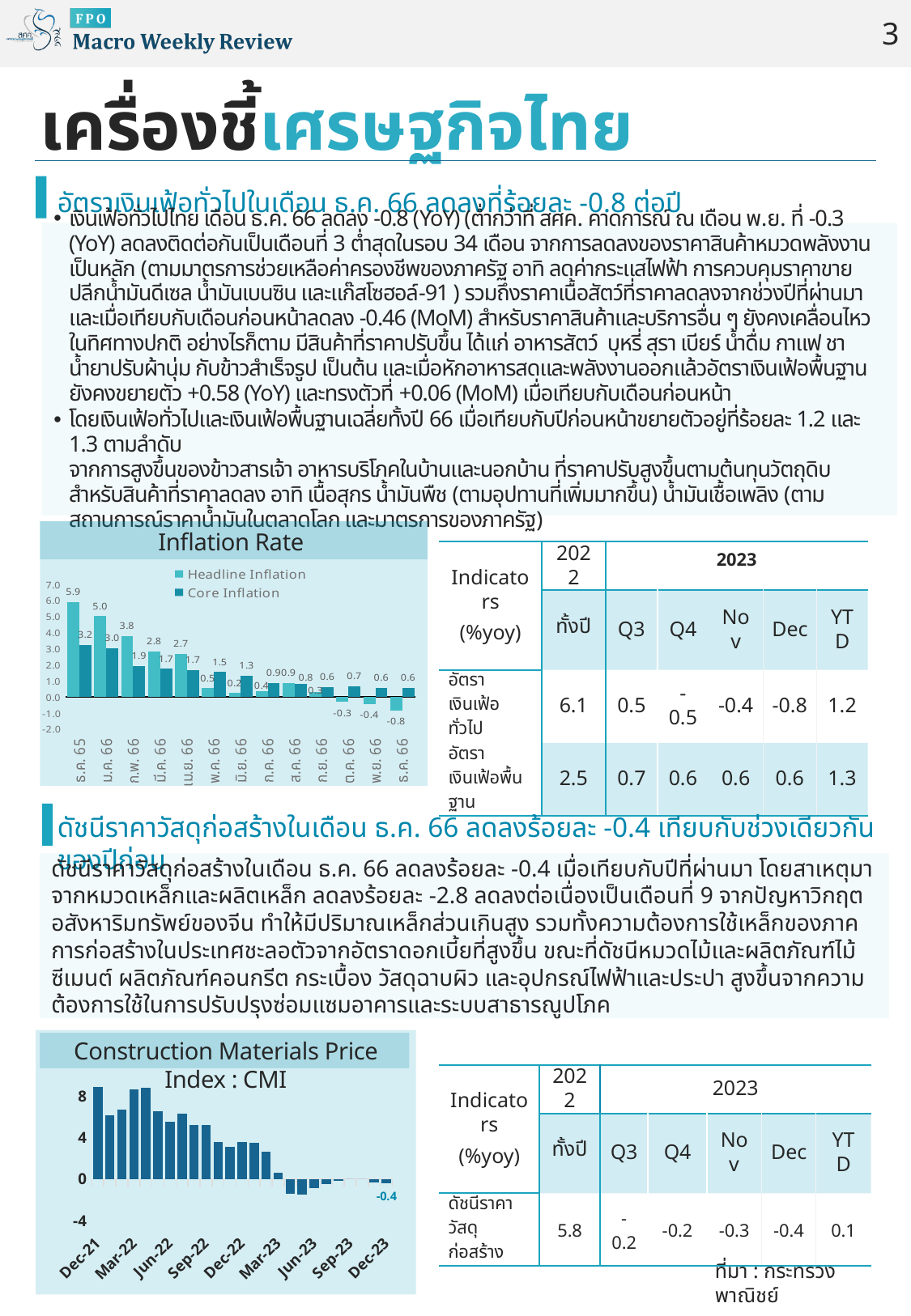
In the Inflation Rate chart, which month has the lowest Headline Inflation? ธ.ค. 66 In the Inflation Rate chart, what is the Core Inflation value for ธ.ค. 66? 0.6 In the Construction Materials Price Index : CMI chart, is the value for Dec-21 greater or less than 4? greater In the Inflation Rate chart, what is the Headline Inflation value for ธ.ค. 65? 5.9 What kind of chart is the Inflation Rate chart? bar chart In the Inflation Rate chart, what is the Headline Inflation value for ธ.ค. 66? -0.8 In the Inflation Rate chart, which is larger for ธ.ค. 66: Headline Inflation or Core Inflation? Core Inflation In the Inflation Rate chart, what is the difference between Headline Inflation and Core Inflation for ธ.ค. 65? 2.7 How many series does the legend of the Inflation Rate chart list? 2 What kind of chart is the Construction Materials Price Index : CMI chart? bar chart In the Inflation Rate chart, which month has the highest Headline Inflation? ธ.ค. 65 In the Inflation Rate chart, does Headline Inflation generally rise or fall from ธ.ค. 65 to ธ.ค. 66? fall